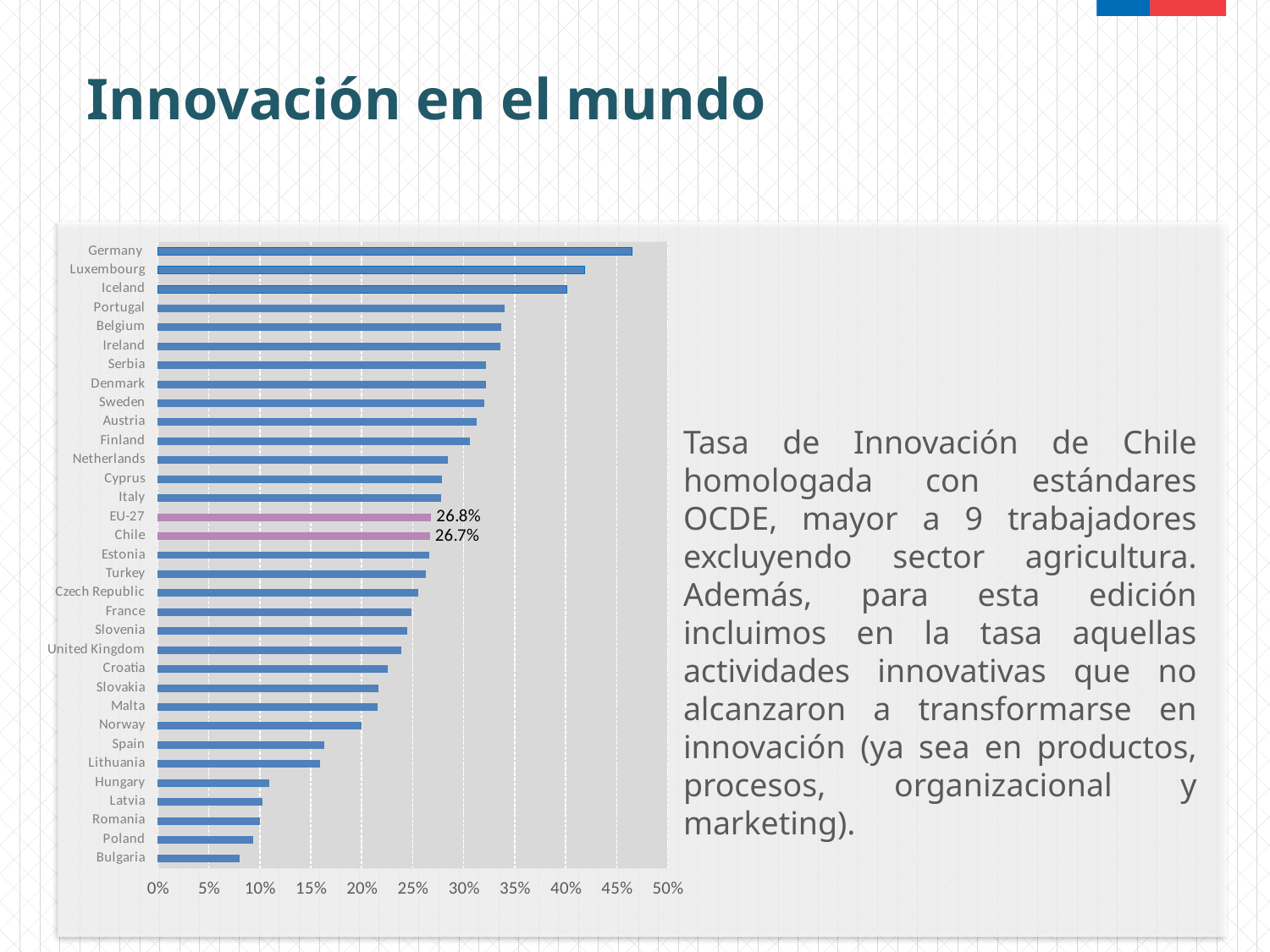
How many countries or regions are listed in the chart? 33 Which country has the highest value in the chart? Germany What type of chart is shown on the slide? Bar chart Is the value for Bulgaria greater or less than 10%? less What value is shown for Chile? 26.7% Is the value for Portugal greater or less than 35%? less Which country has the lowest value in the chart? Bulgaria Is the value for Germany greater or less than 40%? greater What value is shown for EU-27? 26.8% Which has the larger value, EU-27 or Chile? EU-27 What is the difference between the values for EU-27 and Chile? 0.1% Which has the larger value, Germany or Luxembourg? Germany